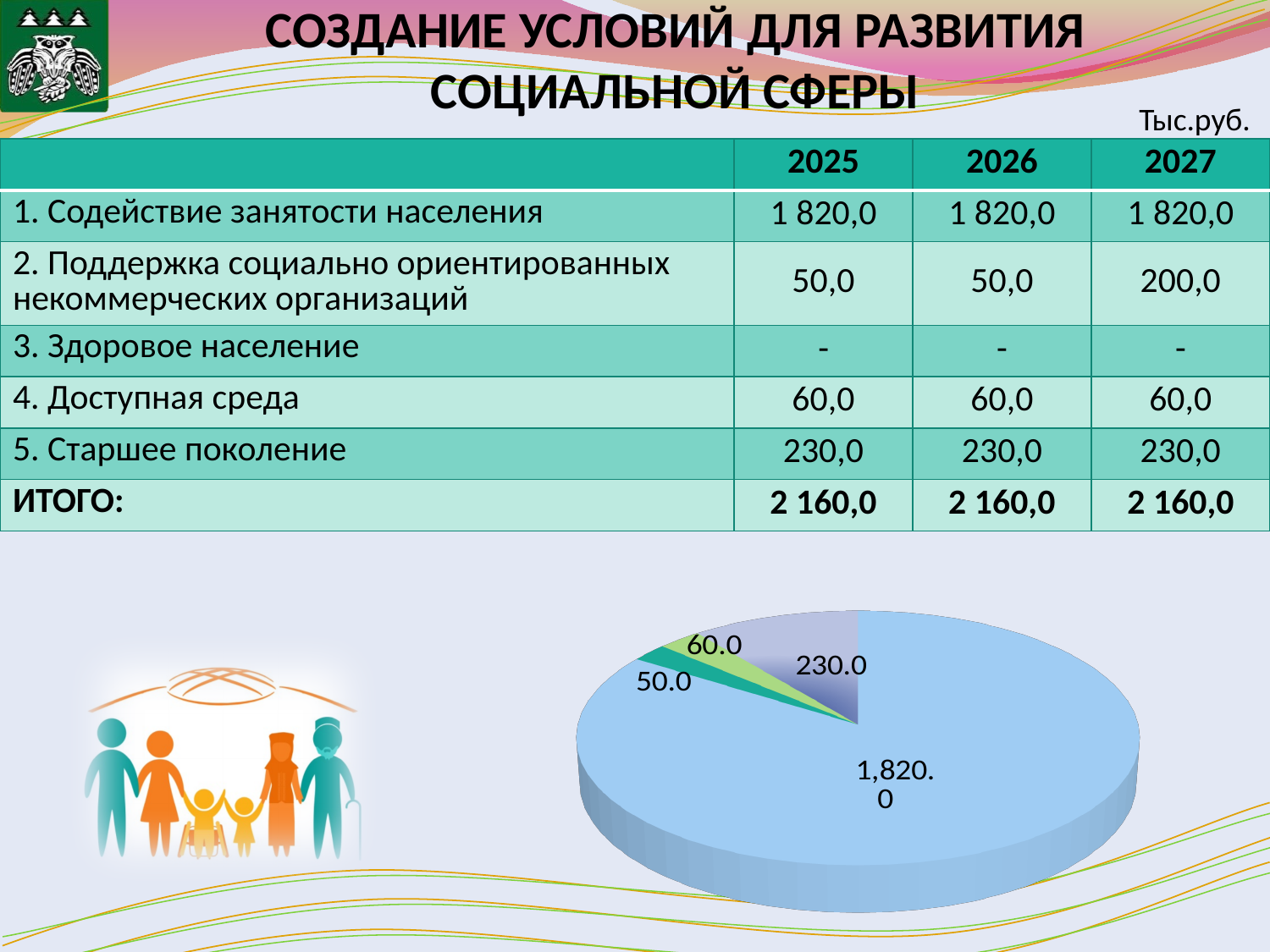
What is the difference between the 1,820.0 slice and the 230.0 slice in the pie chart? 1,590.0 What is the value of the largest slice in the pie chart? 1,820.0 In the pie chart, which is larger: the slice labelled 230.0 or the slice labelled 60.0? 230.0 Which row of the table corresponds to the largest slice (1,820.0) of the pie chart? 1. Содействие занятости населения What is the difference between the 60.0 slice and the 50.0 slice in the pie chart? 10.0 Does the pie chart have a legend? No How many slices does the pie chart have? 4 What value is labelled on the light blue slice of the pie chart? 1,820.0 What is the value of the smallest slice in the pie chart? 50.0 What is the total of all four slice values in the pie chart? 2,160.0 What value is labelled on the grey-blue slice of the pie chart? 230.0 What kind of chart is shown at the bottom of the slide? pie chart